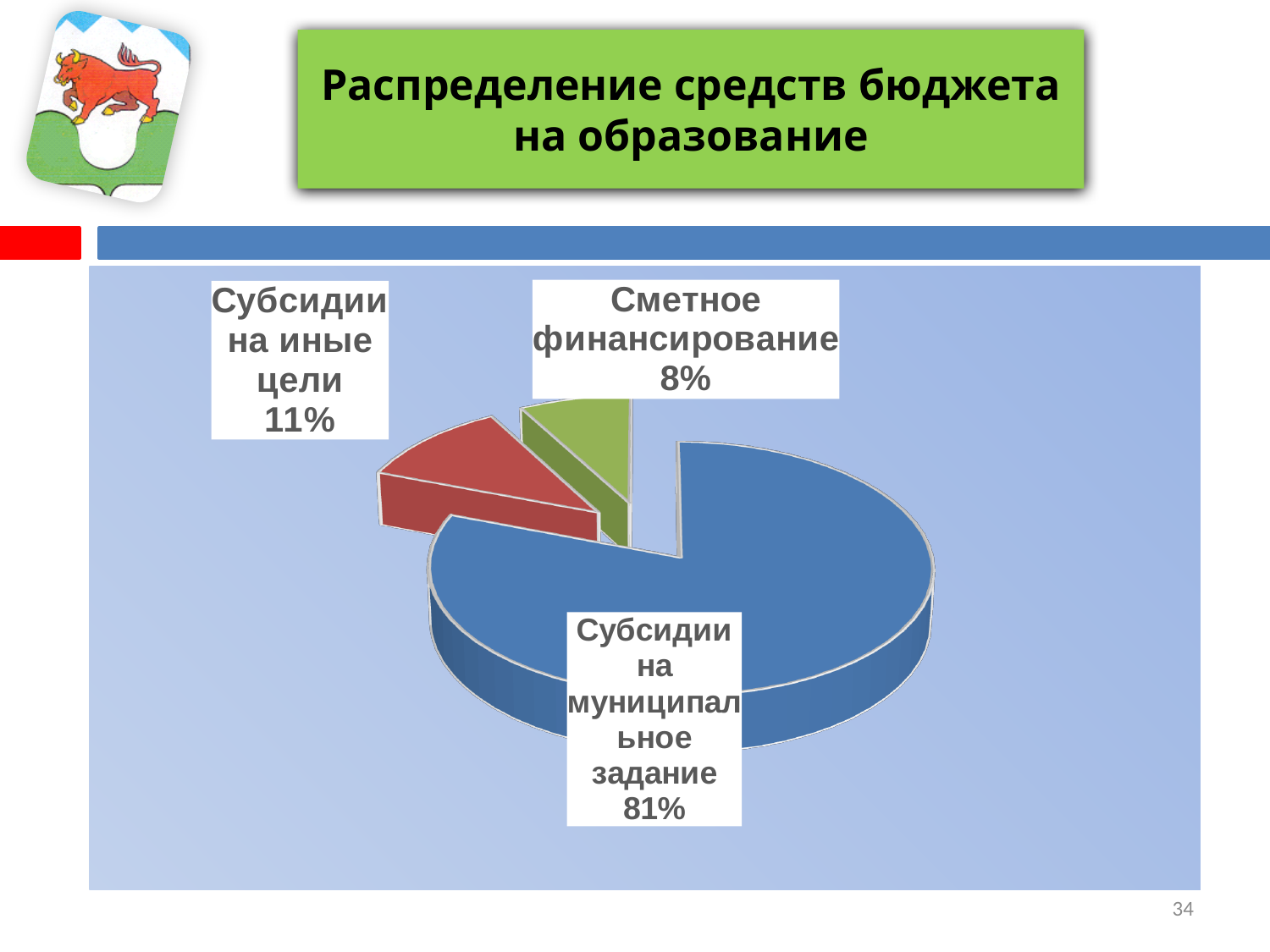
What is the difference in percentage points between "Субсидии на муниципальное задание" and "Субсидии на иные цели"? 70% How many slices does the pie chart have? 3 What share of the pie does "Субсидии на муниципальное задание" have? 81% What share of the pie does "Субсидии на иные цели" have? 11% What share of the pie does "Сметное финансирование" have? 8% What kind of chart is shown on the slide? pie chart Which category has the smallest slice of the pie? Сметное финансирование Which is larger: the share for "Субсидии на иные цели" or the share for "Сметное финансирование"? Субсидии на иные цели Which category has the largest slice of the pie? Субсидии на муниципальное задание What is the title of the slide containing the pie chart? Распределение средств бюджета на образование What colour is the slice for "Субсидии на иные цели"? red What is the difference in percentage points between "Субсидии на иные цели" and "Сметное финансирование"? 3%